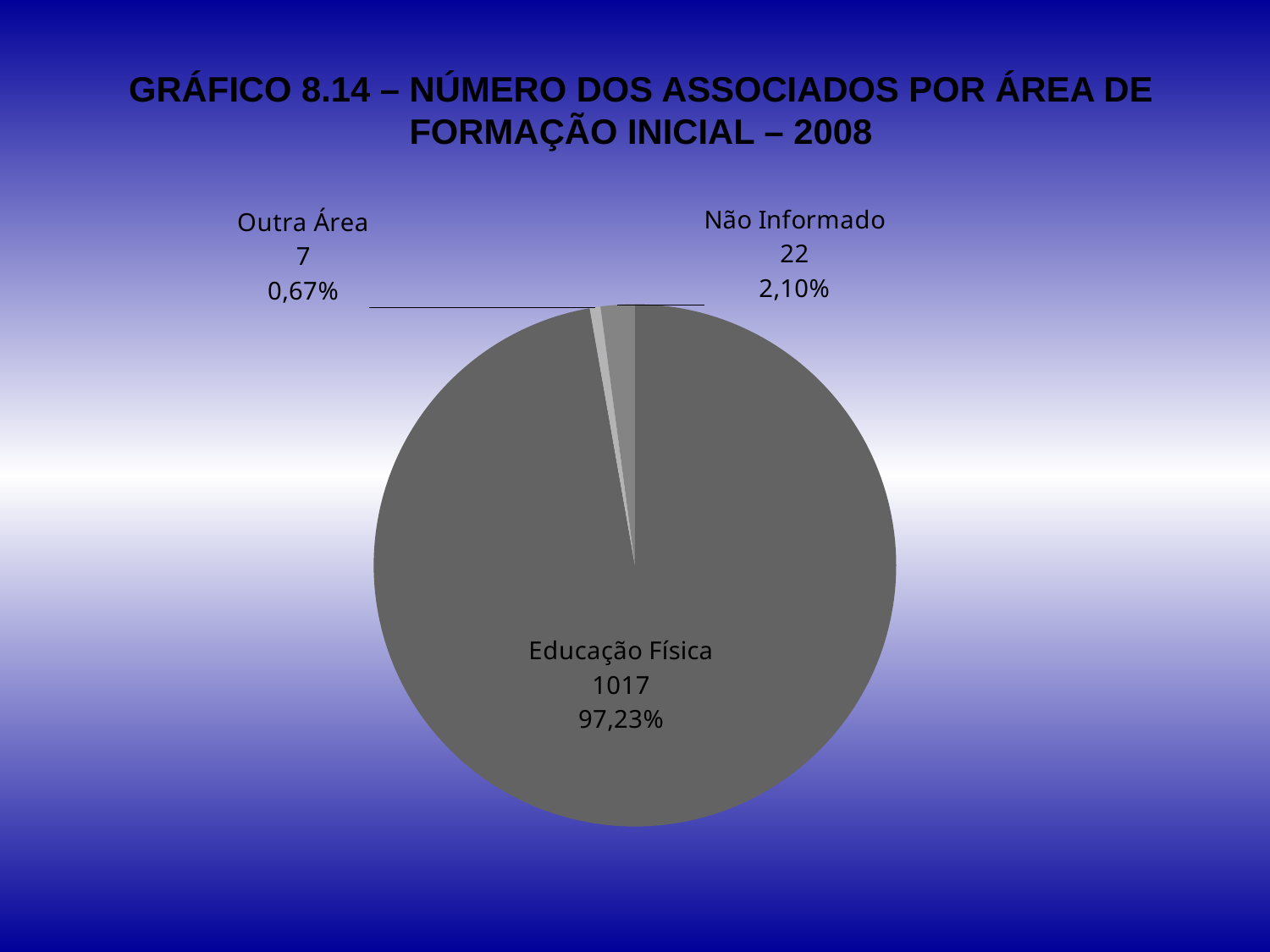
How many slices does the pie chart have? 3 Which category has the smallest slice? Outra Área What share of the pie does Educação Física represent? 97,23% What is the number of associates for Outra Área? 7 What is the title of the chart? GRÁFICO 8.14 – NÚMERO DOS ASSOCIADOS POR ÁREA DE FORMAÇÃO INICIAL – 2008 What kind of chart is shown on the slide? pie chart What share of the pie does Outra Área represent? 0,67% What is the number of associates for Educação Física? 1017 What share of the pie does Não Informado represent? 2,10% Which category has the largest slice? Educação Física What is the difference between the number of associates for Não Informado and Outra Área? 15 What is the number of associates for Não Informado? 22